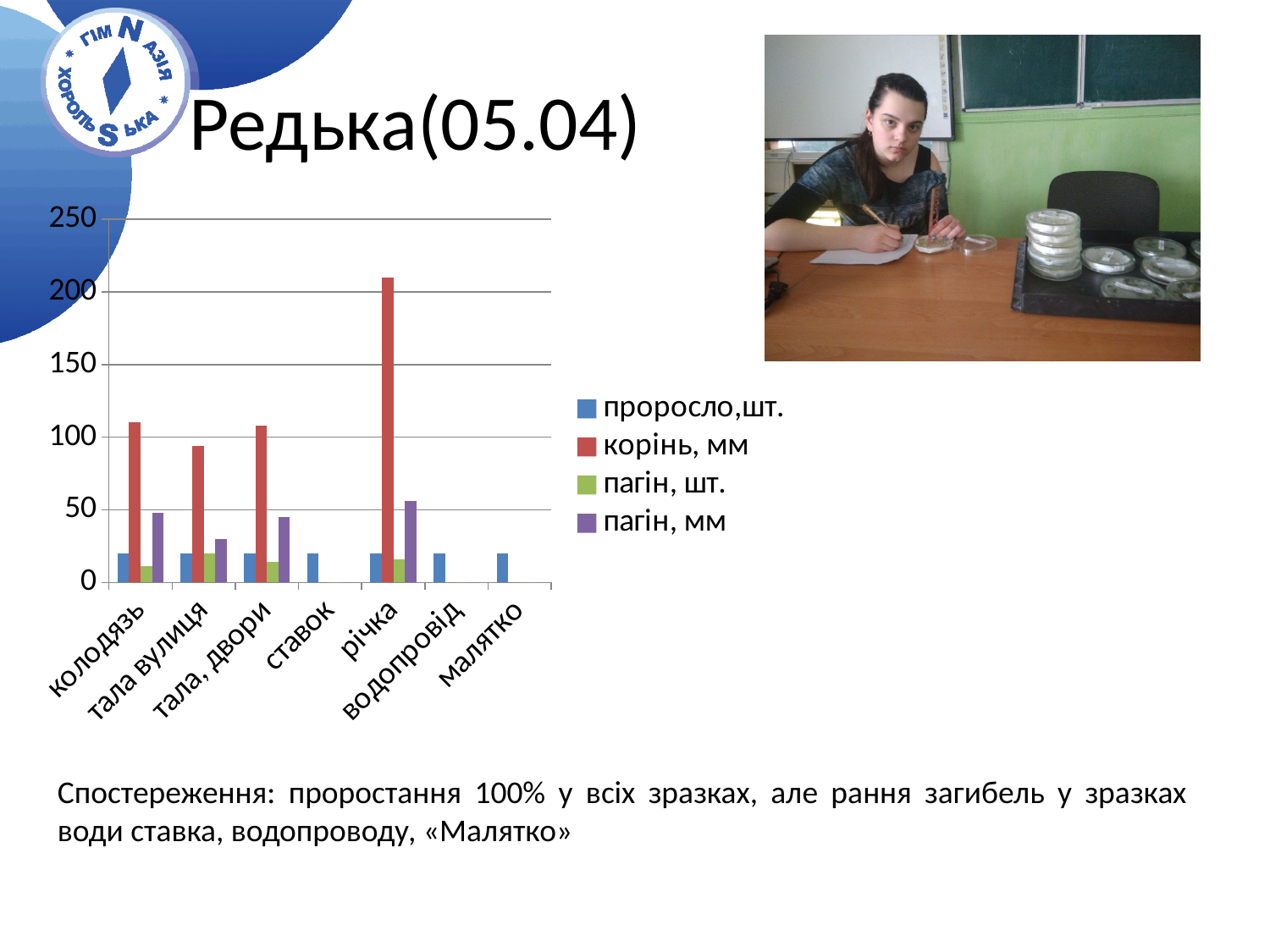
How many categories are shown on the x axis of the chart? 7 What is the highest value shown on the vertical axis of the chart? 250 Is the value of 'пагін, мм' for тала вулиця greater or less than 50? less What is the title of the chart on the slide? Редька(05.04) How many series does the chart legend list? 4 Is the value of 'корінь, мм' for тала вулиця greater or less than 100? less Is the value of 'корінь, мм' for річка greater or less than 200? greater What kind of chart is shown on the slide? bar chart Which is larger: the 'пагін, мм' value for колодязь or for тала вулиця? колодязь Which is larger: the 'корінь, мм' value for річка or for колодязь? річка Which category has the highest value for the series 'корінь, мм'? річка Which legend entry is shown in red in the chart? корінь, мм